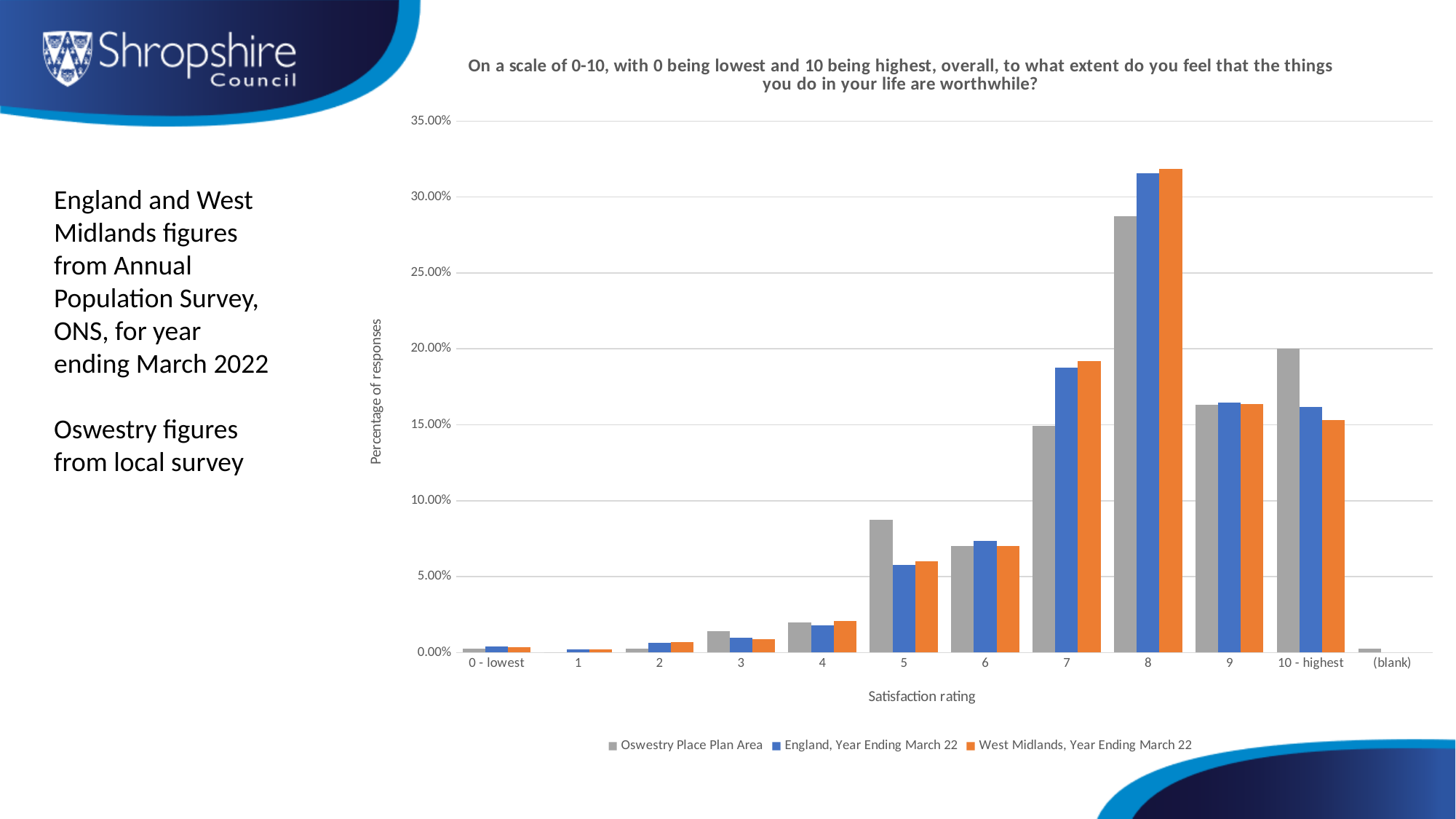
Is the West Midlands, Year Ending March 22 value for rating 7 greater or less than 15.00%? greater At rating 7, which is larger: the Oswestry Place Plan Area value or the England, Year Ending March 22 value? England, Year Ending March 22 What is the label on the y axis of the chart? Percentage of responses At rating 10 - highest, which is larger: the Oswestry Place Plan Area value or the West Midlands, Year Ending March 22 value? Oswestry Place Plan Area Which satisfaction rating has the highest value for the England, Year Ending March 22 series? 8 How many satisfaction rating categories are shown on the x axis? 12 Is the Oswestry Place Plan Area value for rating 8 greater or less than 25.00%? greater Is the England, Year Ending March 22 value for rating 8 greater or less than 30.00%? greater What kind of chart is shown on the slide? Bar chart How many series does the legend list? 3 Which satisfaction rating has the highest value for the Oswestry Place Plan Area series? 8